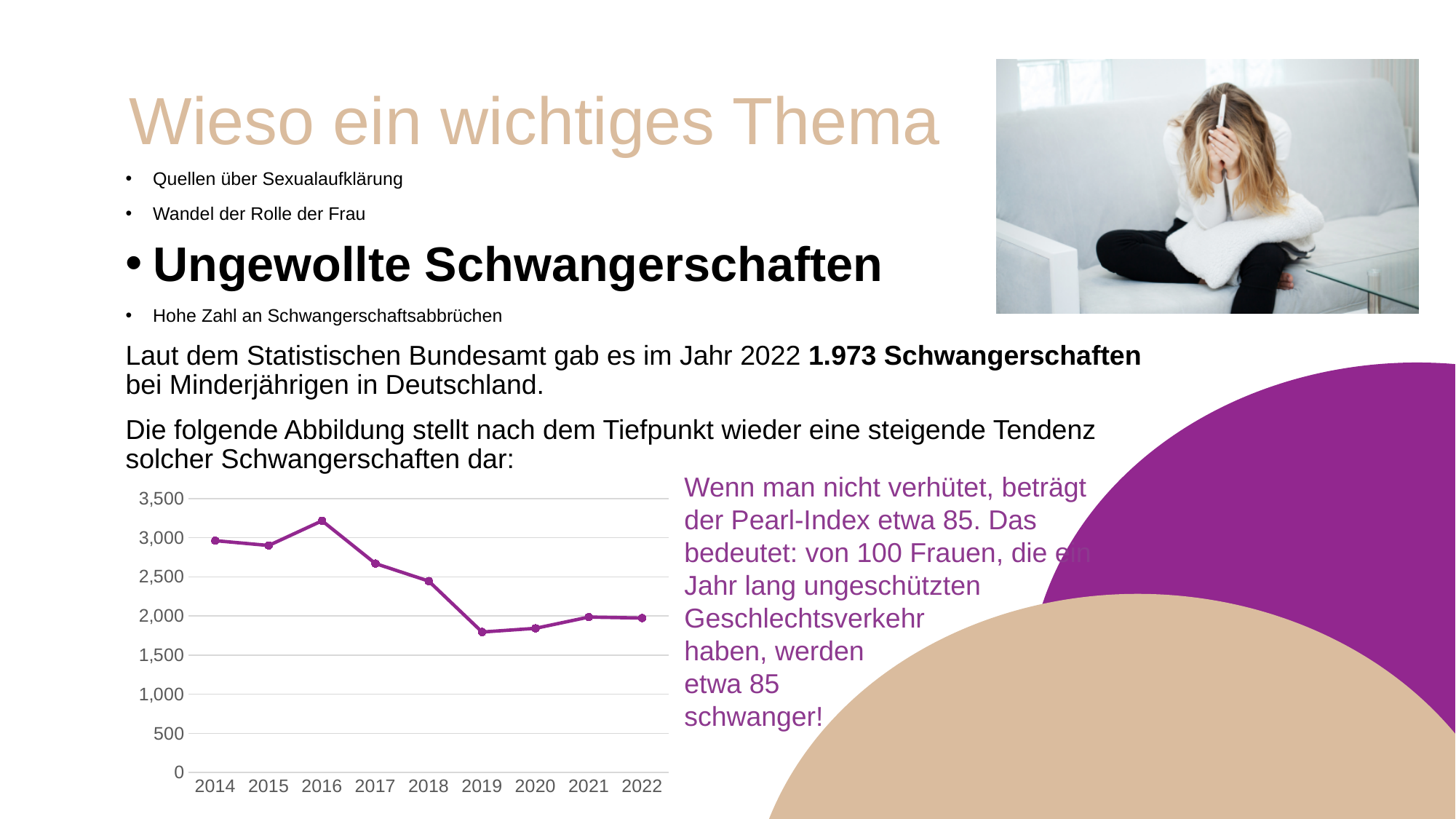
Is the value for 2016 greater or less than 3,000? greater Which year has the highest value in the chart? 2016 Which year has the larger value, 2019 or 2021? 2021 Do the values generally rise or fall from 2016 to 2019? fall What is the first year shown on the x axis of the chart? 2014 Is the value for 2019 greater or less than 2,000? less Which year has the larger value, 2014 or 2020? 2014 What kind of chart is shown on the slide? line chart How many years are plotted along the x axis of the chart? 9 Which year has the lowest value in the chart? 2019 Is the value for 2017 greater or less than 2,500? greater